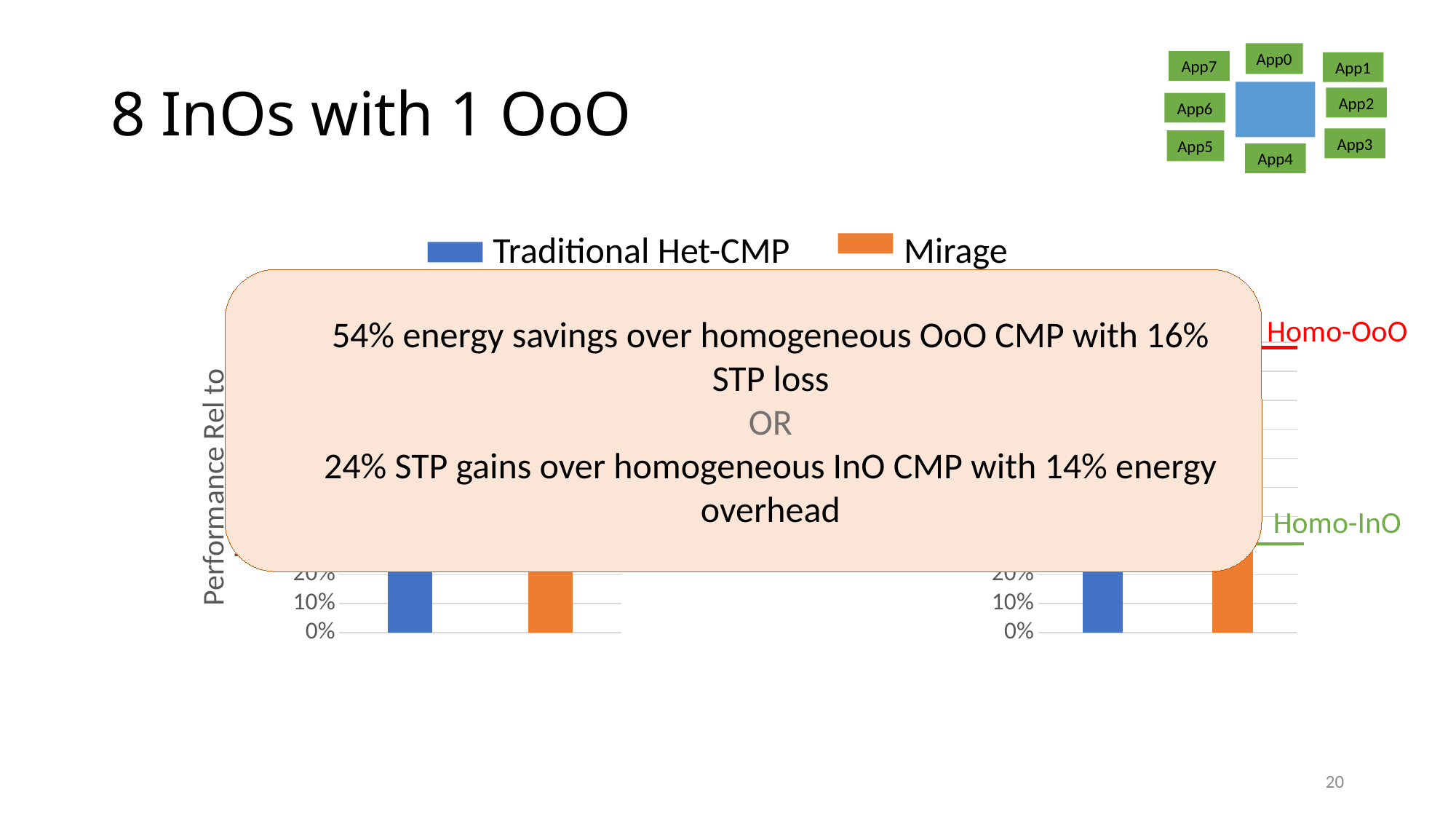
Which colour represents the Mirage series in the legend? Orange In the right chart, is the value of the Traditional Het-CMP bar greater or less than 20%? greater What are the two series named in the legend? Traditional Het-CMP and Mirage In the left chart, is the value of the Traditional Het-CMP bar greater or less than 20%? greater What kind of chart is shown on the slide? Bar chart How many series does the legend list? 2 How many charts are shown on the slide? 2 In the left chart, is the value of the Mirage bar greater or less than 20%? greater How many bars are visible in the right chart? 2